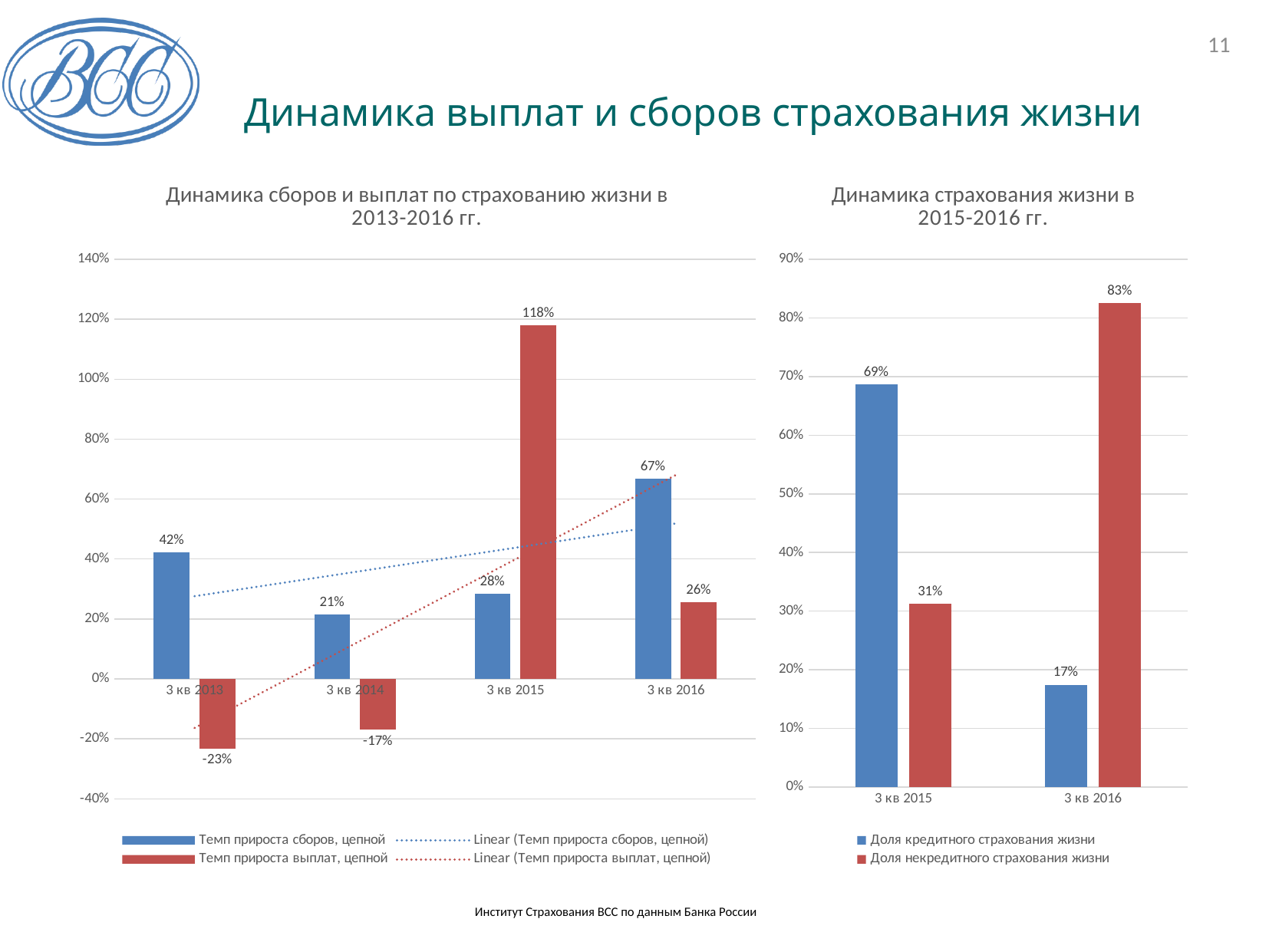
In the left chart 'Динамика сборов и выплат по страхованию жизни в 2013-2016 гг.', how many quarters are shown on the x axis? 4 In the right chart 'Динамика страхования жизни в 2015-2016 гг.', what is the difference between 'Доля кредитного страхования жизни' in 3 кв 2015 and 3 кв 2016? 52% In the right chart 'Динамика страхования жизни в 2015-2016 гг.', which is larger for 3 кв 2015: 'Доля кредитного страхования жизни' or 'Доля некредитного страхования жизни'? Доля кредитного страхования жизни In the left chart 'Динамика сборов и выплат по страхованию жизни в 2013-2016 гг.', which quarter has the lowest value of 'Темп прироста выплат, цепной'? 3 кв 2013 In the left chart 'Динамика сборов и выплат по страхованию жизни в 2013-2016 гг.', what is the value of 'Темп прироста выплат, цепной' for 3 кв 2015? 118% What type of chart is the right chart 'Динамика страхования жизни в 2015-2016 гг.'? Bar chart In the left chart 'Динамика сборов и выплат по страхованию жизни в 2013-2016 гг.', which quarter has the highest value of 'Темп прироста сборов, цепной'? 3 кв 2016 In the left chart 'Динамика сборов и выплат по страхованию жизни в 2013-2016 гг.', how many entries does the legend list? 4 In the left chart 'Динамика сборов и выплат по страхованию жизни в 2013-2016 гг.', what is the value of 'Темп прироста сборов, цепной' for 3 кв 2013? 42% In the left chart 'Динамика сборов и выплат по страхованию жизни в 2013-2016 гг.', what is the value of 'Темп прироста выплат, цепной' for 3 кв 2014? -17% In the left chart 'Динамика сборов и выплат по страхованию жизни в 2013-2016 гг.', what is the difference between 'Темп прироста сборов, цепной' and 'Темп прироста выплат, цепной' for 3 кв 2016? 41% In the right chart 'Динамика страхования жизни в 2015-2016 гг.', what is the value of 'Доля некредитного страхования жизни' for 3 кв 2016? 83%